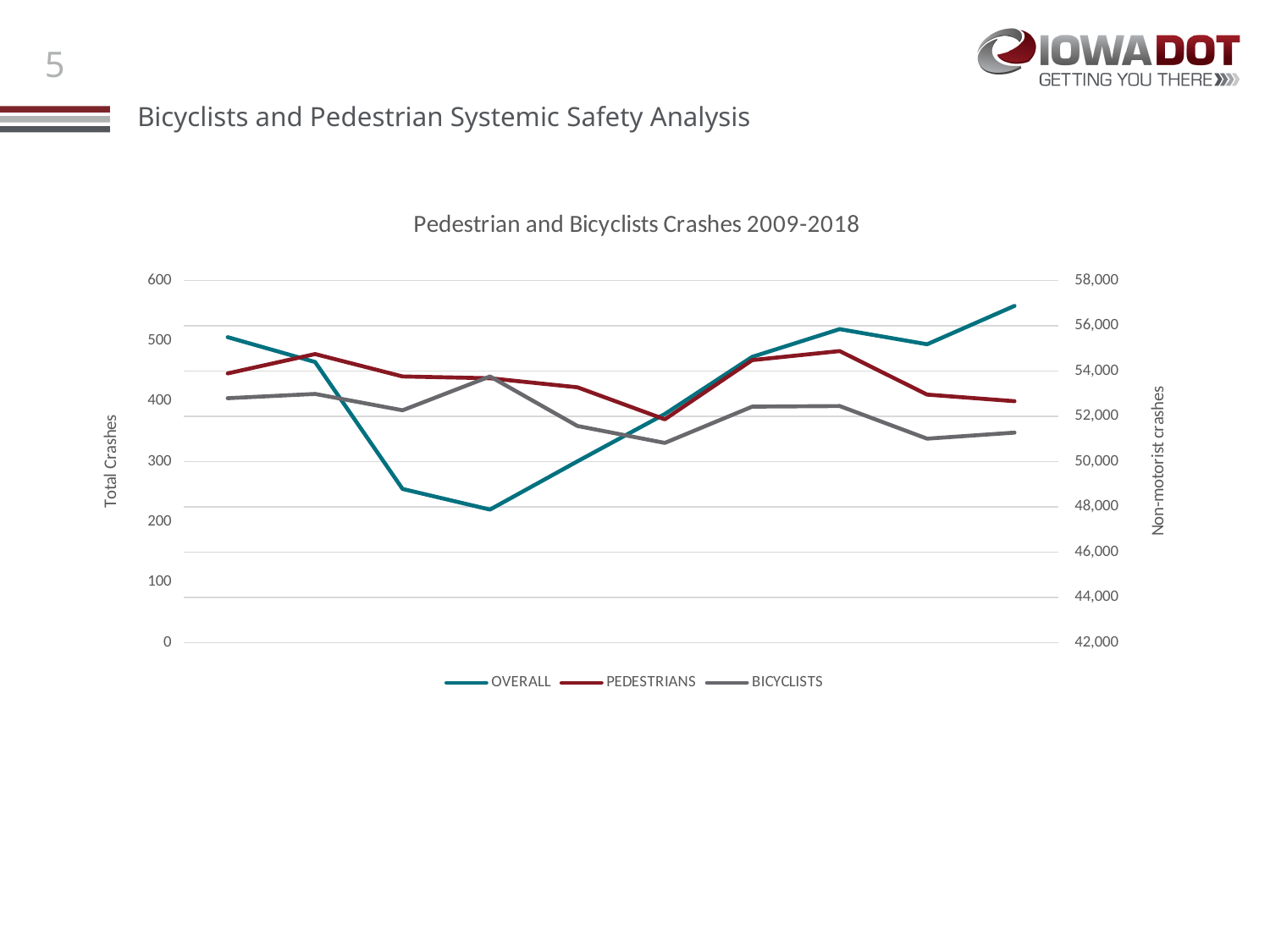
How many data points does each line have? 10 How many series does the legend list? 3 Does the PEDESTRIANS line end higher or lower at its rightmost point than at its leftmost point? lower What kind of chart is shown on the slide? line chart Does the OVERALL line end higher or lower at its rightmost point than at its leftmost point? higher At the rightmost point, which line is higher: PEDESTRIANS or BICYCLISTS? PEDESTRIANS Is the leftmost value of the PEDESTRIANS line greater or less than 400 on the left axis? greater At the leftmost point, which line is higher: PEDESTRIANS or BICYCLISTS? PEDESTRIANS What is the title of the left vertical axis? Total Crashes Is the leftmost value of the BICYCLISTS line greater or less than 300 on the left axis? greater Is the rightmost value of the BICYCLISTS line greater or less than 400 on the left axis? less What is the title of the chart? Pedestrian and Bicyclists Crashes 2009-2018